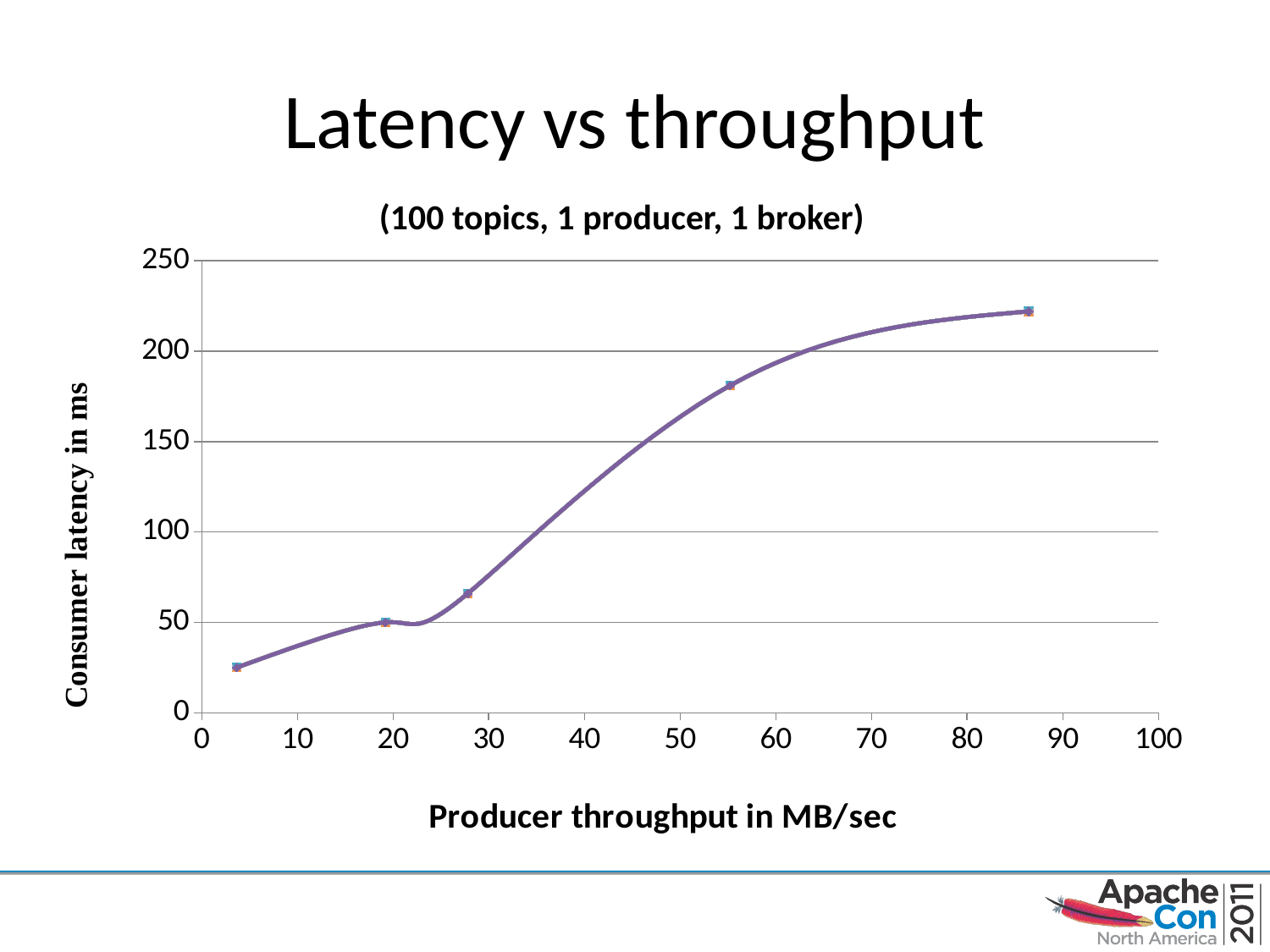
Is the consumer latency at the lowest plotted producer throughput greater or less than 50 ms? less Is the consumer latency higher at the highest plotted throughput or at the lowest plotted throughput? highest plotted throughput Is the consumer latency at the second-highest plotted producer throughput (just above 50 MB/sec) greater or less than 150 ms? greater Is the consumer latency at the point near 28 MB/sec greater or less than 50 ms? greater How many data points are plotted on the chart? 5 What kind of chart is shown on the slide? line chart What is the label of the vertical axis? Consumer latency in ms Does consumer latency rise or fall as producer throughput increases along the x axis? rise What is the title printed above the chart? (100 topics, 1 producer, 1 broker)